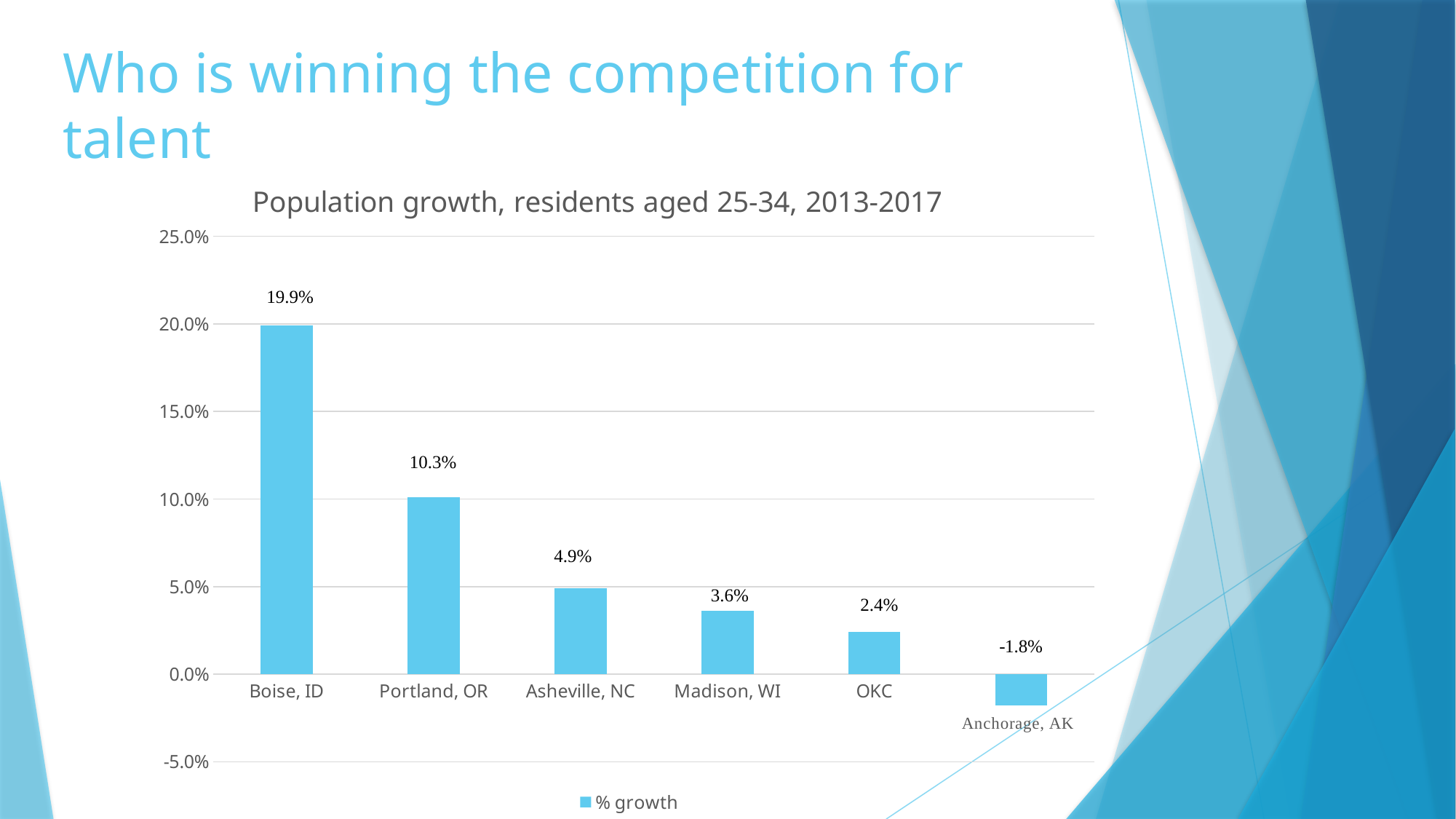
Which has a larger value, Asheville, NC or OKC? Asheville, NC What is the population growth value for Boise, ID? 19.9% What kind of chart is shown on the slide? bar chart What is the title of the chart? Population growth, residents aged 25-34, 2013-2017 How many cities are shown on the chart? 6 How many series does the legend list? 1 Which city has the highest population growth? Boise, ID Which city has the lowest population growth? Anchorage, AK What is the population growth value for Madison, WI? 3.6% What is the difference between the values for Boise, ID and Portland, OR? 9.6% What is the population growth value for Anchorage, AK? -1.8% Is the value for Portland, OR greater or less than 15.0%? less